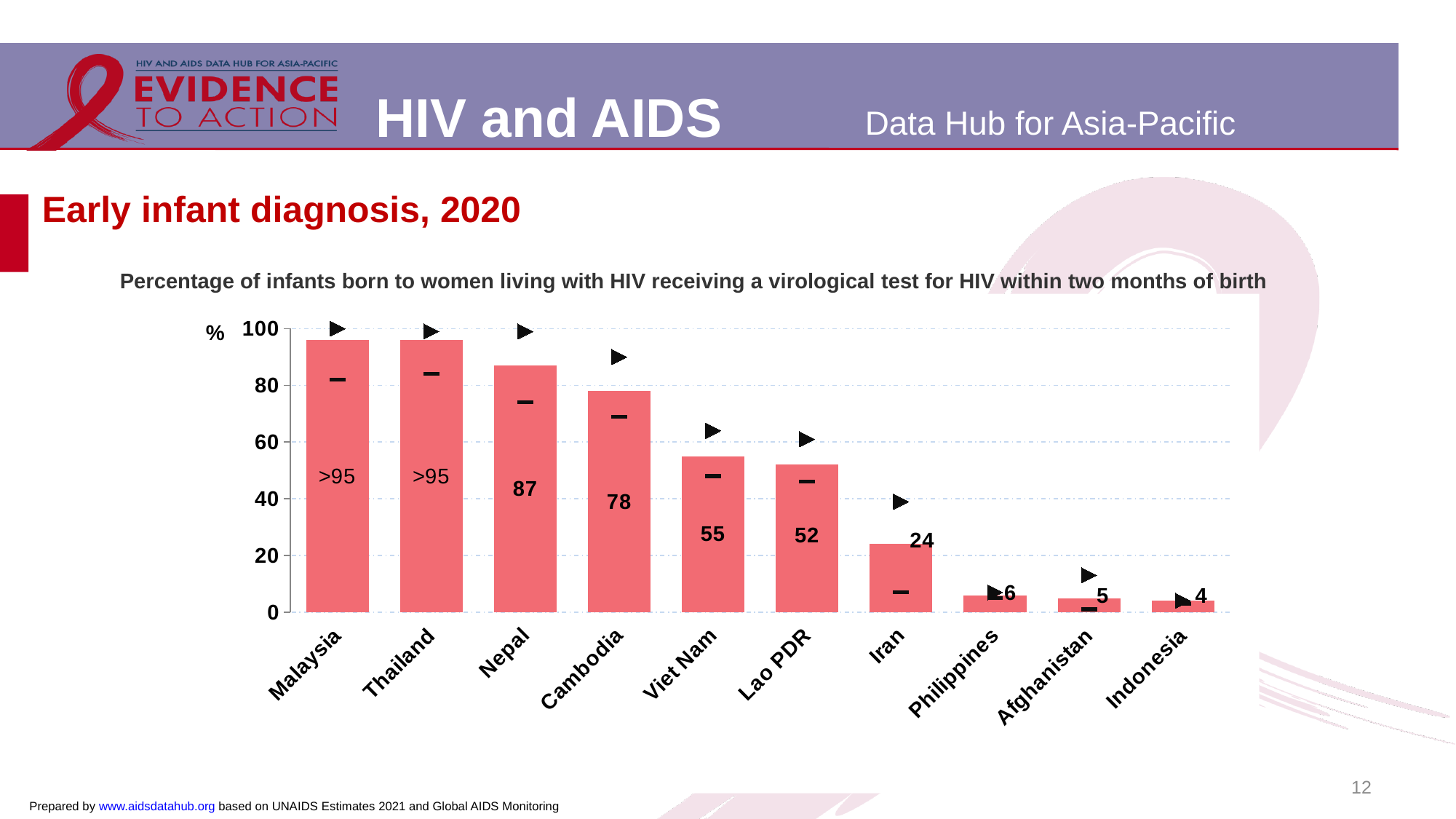
What kind of chart is shown on the slide? Bar chart What is the difference between the values for Viet Nam and Iran? 31 Do the values rise or fall from left to right along the x axis? Fall What is the value for Nepal? 87 What is the value for Cambodia? 78 Which is larger, the value for Viet Nam or the value for Lao PDR? Viet Nam What is the value for Iran? 24 How many countries are shown in the chart? 10 What is the value for Lao PDR? 52 What is the difference between the values for Nepal and Cambodia? 9 Which country has the lowest value? Indonesia What is the value for Malaysia? >95